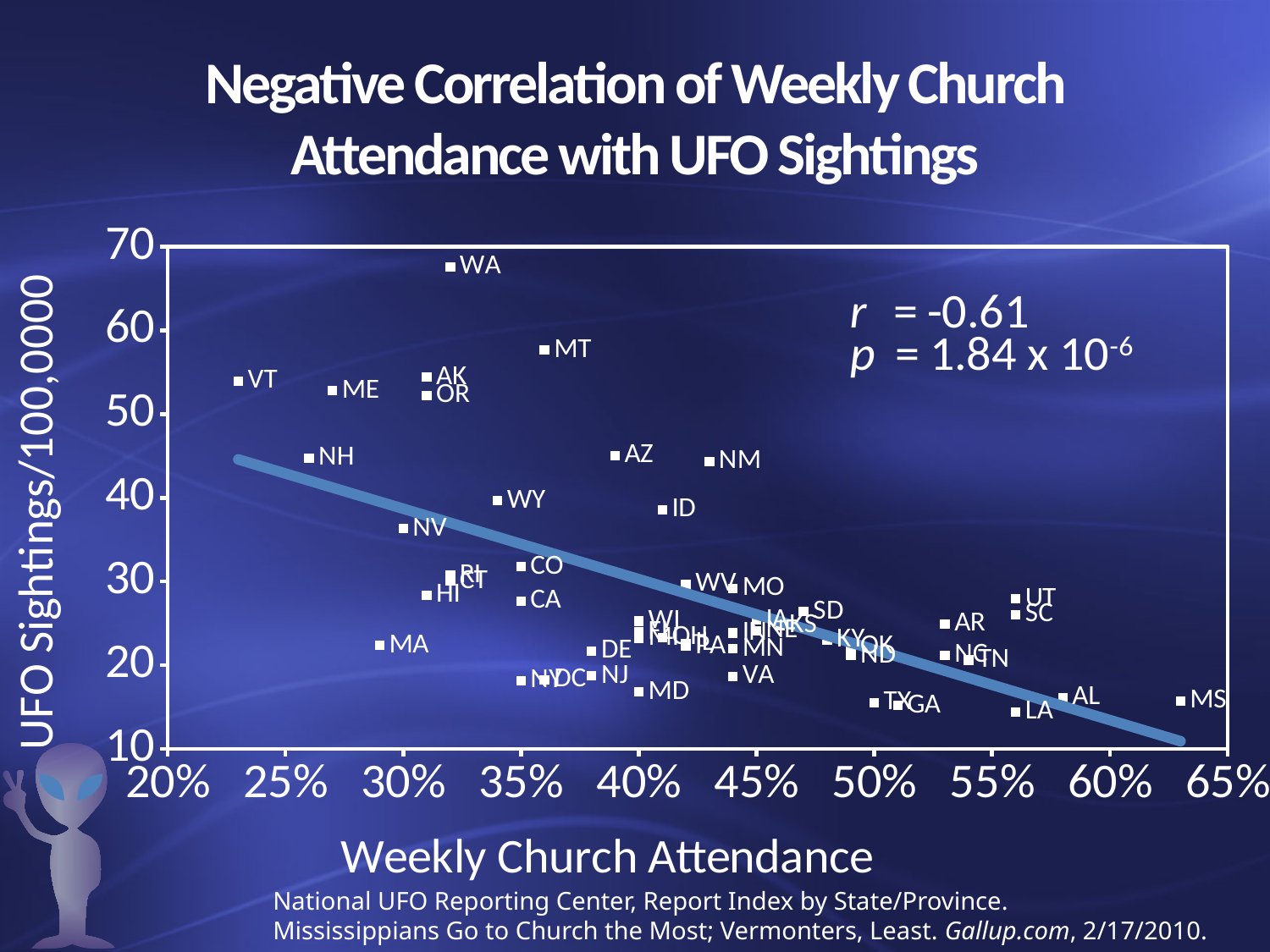
Is the UFO sightings value for WA greater or less than 60? greater As weekly church attendance increases along the x axis, do UFO sightings generally rise or fall? fall Is the UFO sightings value for MT greater or less than 50? greater Which state has more UFO sightings per 100,000, WA or MT? WA Which state has the lowest weekly church attendance on the chart? VT Which state has the highest weekly church attendance on the chart? MS What kind of chart is shown on the slide? Scatter plot Which state has more UFO sightings per 100,000, VT or MA? VT Which state has the highest UFO sightings per 100,000 on the chart? WA Is the UFO sightings value for MA greater or less than 30? less What correlation coefficient r is printed on the chart? -0.61